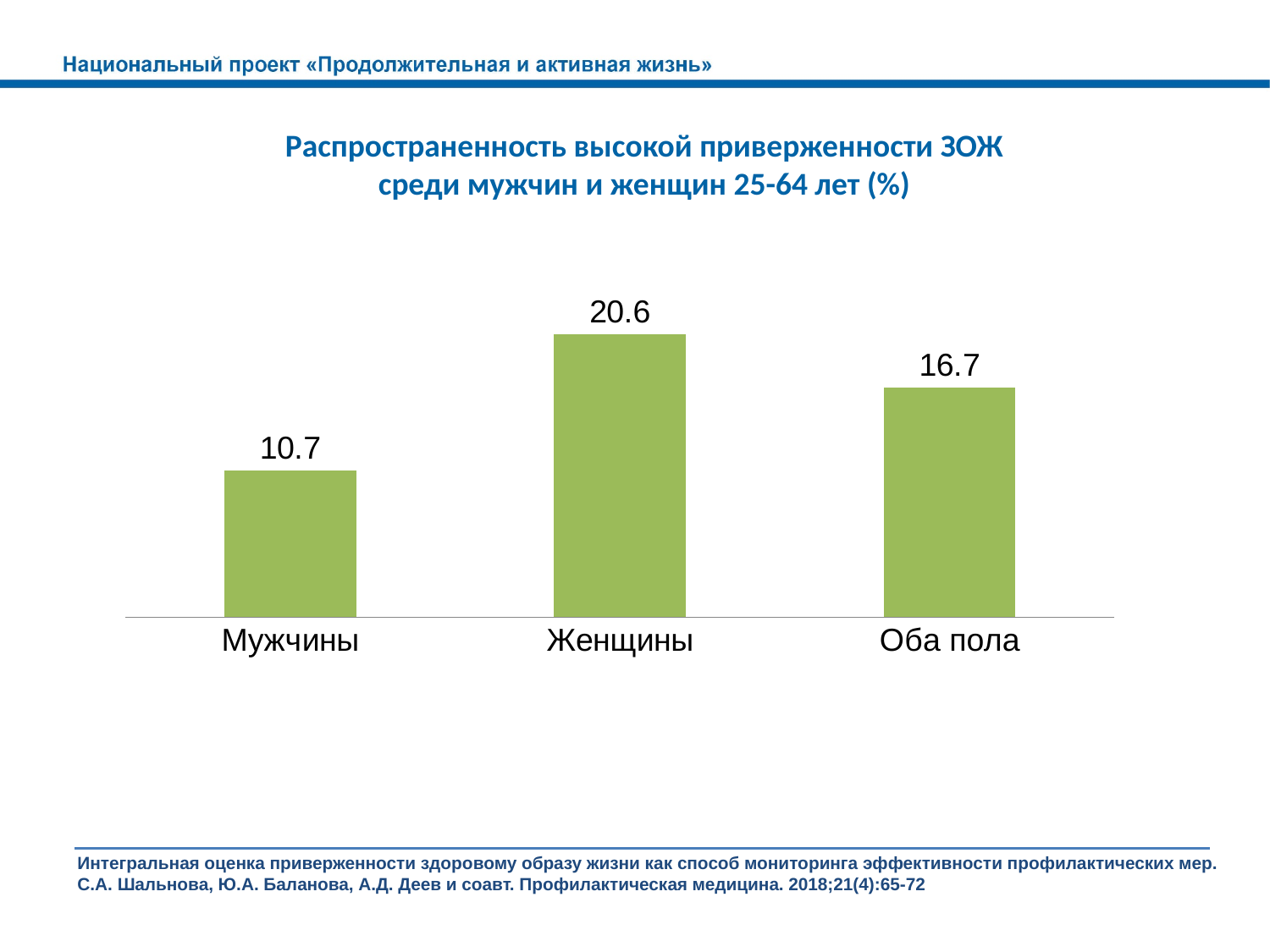
How many categories are shown in the chart? 3 What is the difference between the values for Женщины and Мужчины? 9.9 What is the value for Женщины? 20.6 What colour are the bars in the chart? green What is the value for Мужчины? 10.7 Which category has the lowest value? Мужчины Which category has the highest value? Женщины What is the title of the chart? Распространенность высокой приверженности ЗОЖ среди мужчин и женщин 25-64 лет (%) Which is larger, the value for Мужчины or the value for Оба пола? Оба пола What kind of chart is shown on the slide? bar chart What is the value for Оба пола? 16.7 What is the difference between the values for Женщины and Оба пола? 3.9